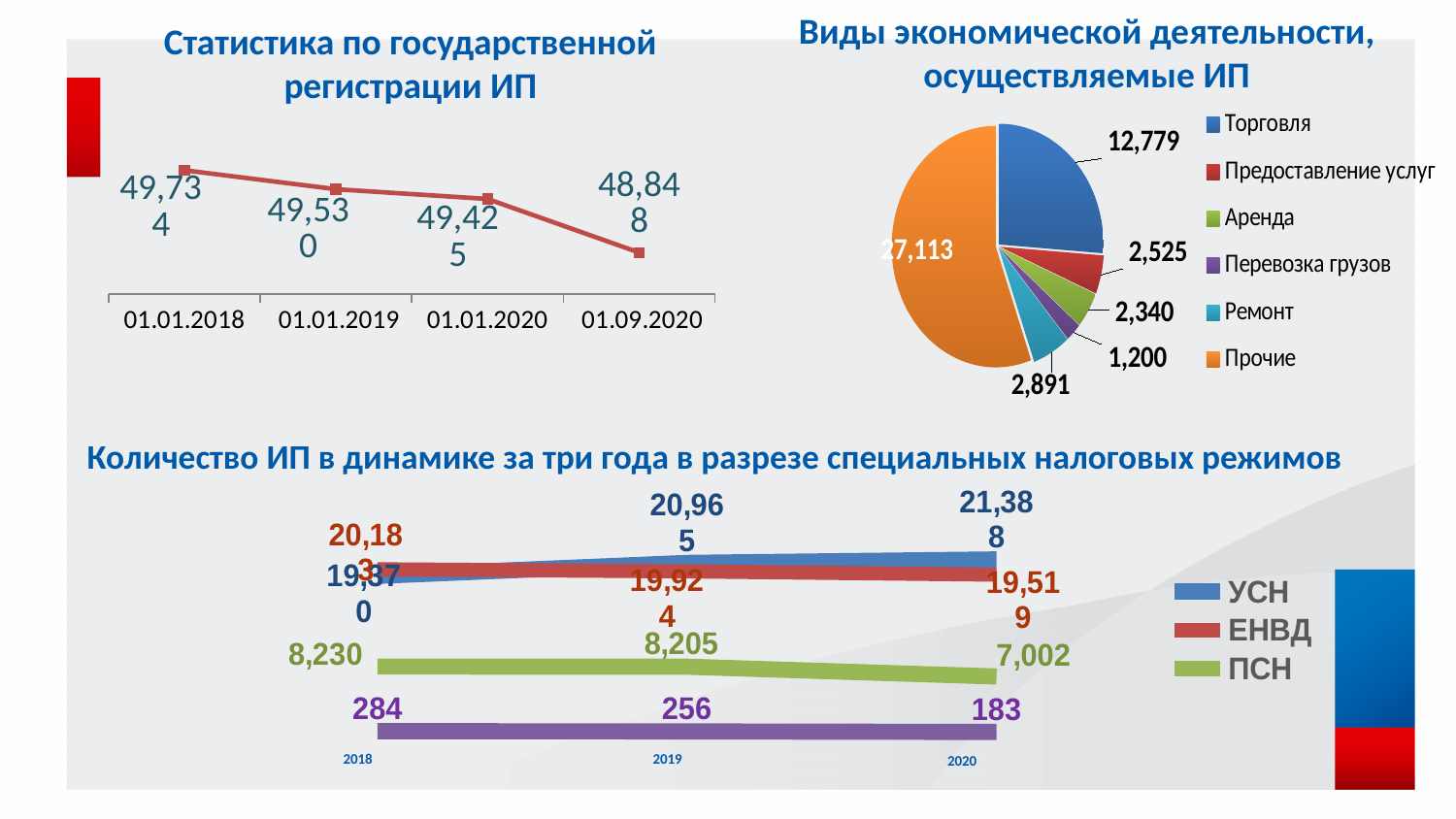
In the top-left chart "Статистика по государственной регистрации ИП", do the values rise or fall from 01.01.2018 to 01.09.2020? fall How many series does the legend of the bottom chart "Количество ИП в динамике за три года в разрезе специальных налоговых режимов" list? 3 In the top-left chart "Статистика по государственной регистрации ИП", what is the value for 01.01.2018? 49,734 In the pie chart "Виды экономической деятельности, осуществляемые ИП", what is the value for Ремонт? 2,891 In the bottom chart "Количество ИП в динамике за три года в разрезе специальных налоговых режимов", what is the difference between the ПСН values for 2018 and 2020? 1,228 In the pie chart "Виды экономической деятельности, осуществляемые ИП", which category has the largest value? Прочие In the top-left chart "Статистика по государственной регистрации ИП", what is the difference between the values for 01.01.2018 and 01.09.2020? 886 What kind of chart is the top-left chart titled "Статистика по государственной регистрации ИП"? line chart In the bottom chart "Количество ИП в динамике за три года в разрезе специальных налоговых режимов", what is the value for ПСН in 2020? 7,002 In the pie chart "Виды экономической деятельности, осуществляемые ИП", which category has the smallest value? Перевозка грузов In the bottom chart "Количество ИП в динамике за три года в разрезе специальных налоговых режимов", which is larger in 2020: УСН or ЕНВД? УСН How many slices does the pie chart "Виды экономической деятельности, осуществляемые ИП" have? 6